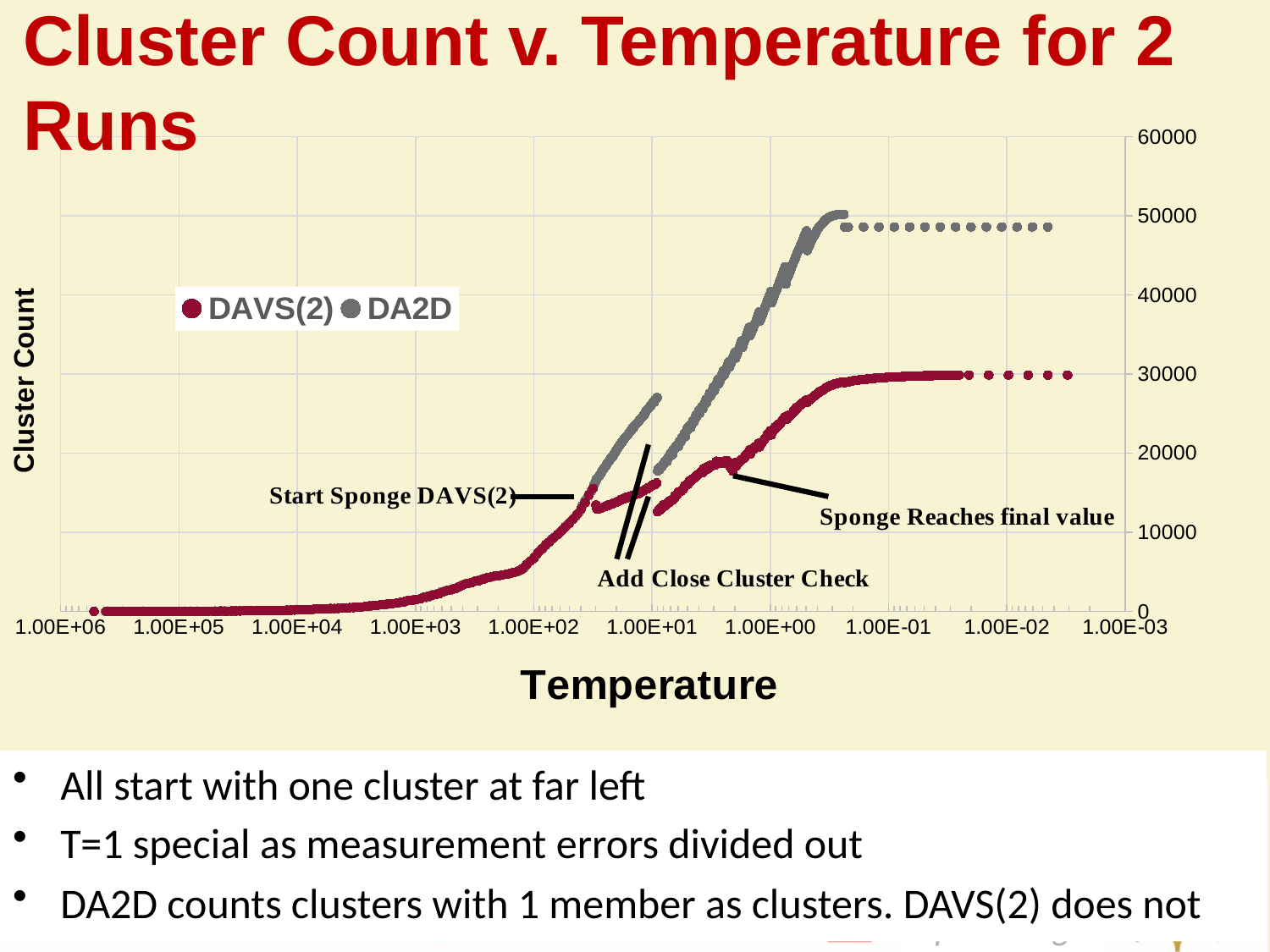
Moving from left to right along the x axis, do the cluster counts generally rise or fall? rise How many series does the legend list? 2 Which series reaches the higher cluster count at the right end of the chart? DA2D Is the final cluster count for DAVS(2) greater or less than 40000? less Is the final cluster count for DA2D greater or less than 40000? greater Is the final cluster count for DAVS(2) greater or less than 20000? greater What kind of chart is shown on the slide? scatter chart What is the title of the x axis? Temperature Which series has the lower cluster count at the right end of the chart? DAVS(2) At a temperature of 1.00E+00, which series has the higher cluster count, DAVS(2) or DA2D? DA2D What are the two series named in the legend? DAVS(2) and DA2D